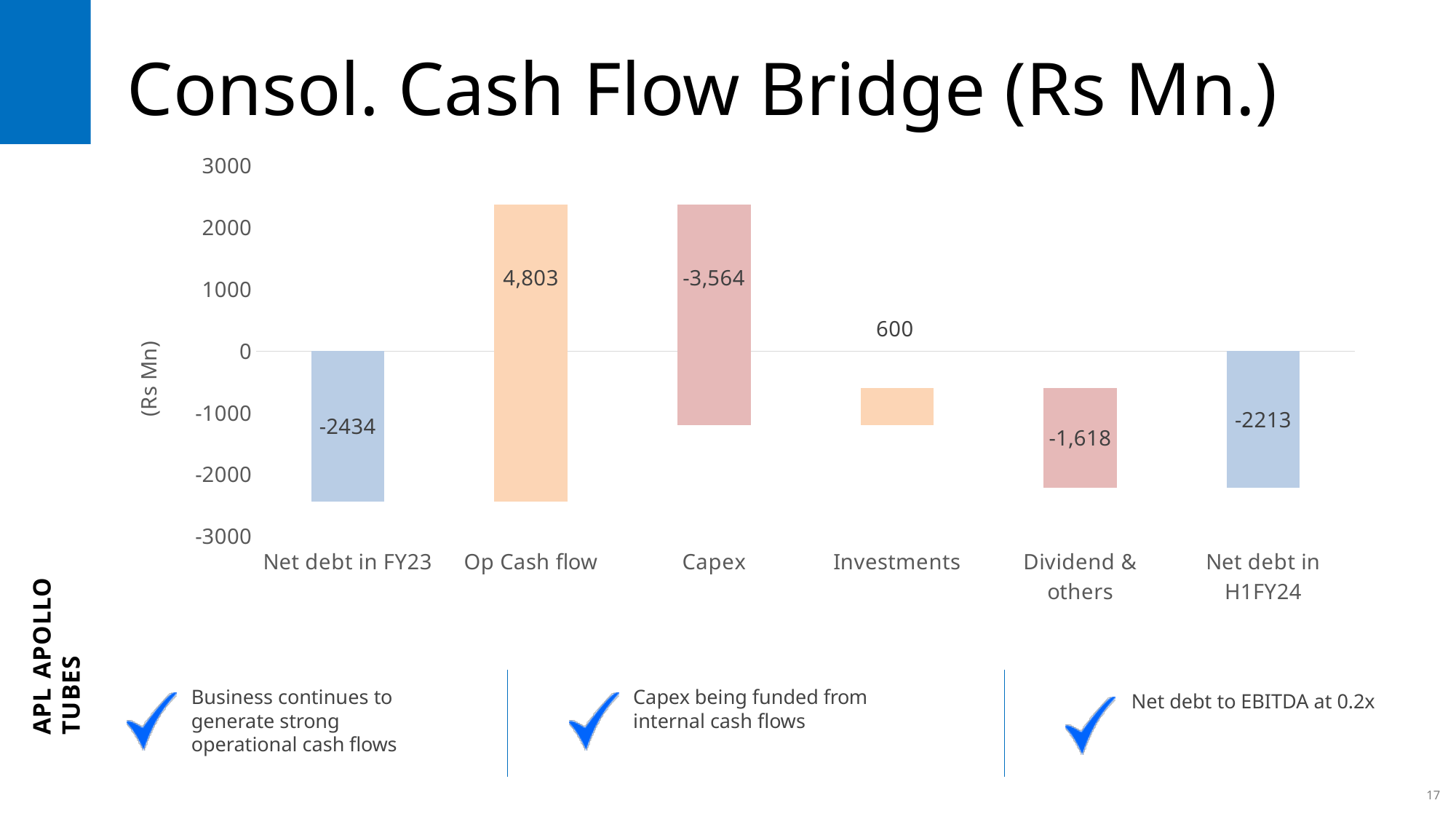
How many categories are shown on the x axis? 6 What is the value for Capex? -3,564 What is the value for Dividend & others? -1,618 What is the difference between Op Cash flow (4,803) and the magnitude of Capex (3,564)? 1,239 What is the label on the vertical axis? (Rs Mn) What is the value for Investments? 600 By how much did net debt fall from FY23 to H1FY24? 221 What is the value for Op Cash flow? 4,803 Which category has the highest value? Op Cash flow Which category has the lowest value? Capex What is the value for Net debt in FY23? -2434 What is the value for Net debt in H1FY24? -2213